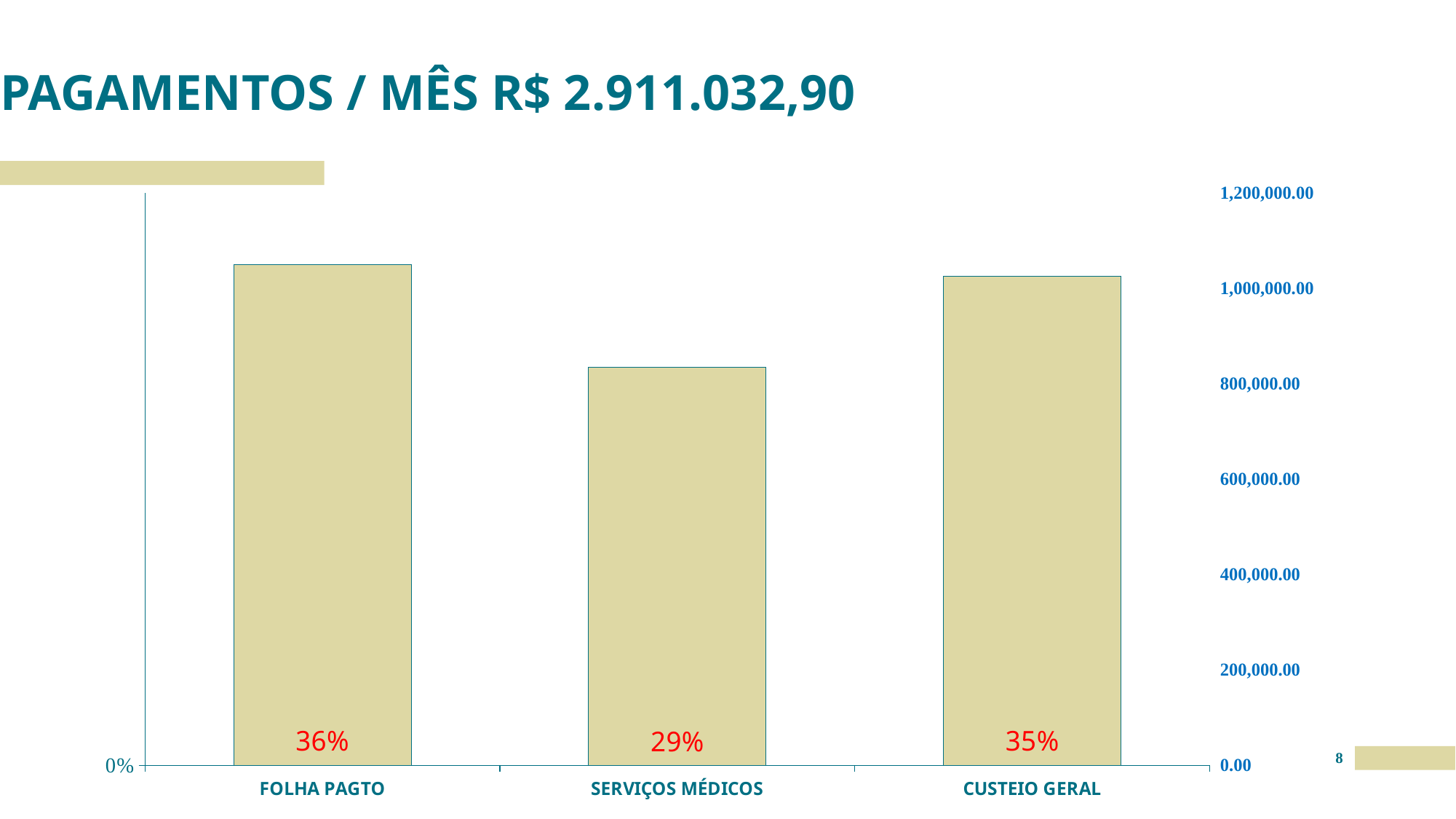
What is the title of the slide? PAGAMENTOS / MÊS R$ 2.911.032,90 Is the value for SERVIÇOS MÉDICOS on the right-hand axis greater or less than 1,000,000.00? less Is the value for FOLHA PAGTO on the right-hand axis greater or less than 1,000,000.00? greater Which has a larger percentage, FOLHA PAGTO or CUSTEIO GERAL? FOLHA PAGTO What is the difference in percentage points between FOLHA PAGTO and SERVIÇOS MÉDICOS? 7% What percentage label is shown on the FOLHA PAGTO bar? 36% What percentage label is shown on the SERVIÇOS MÉDICOS bar? 29% Which category has the highest percentage? FOLHA PAGTO Which category has the lowest percentage? SERVIÇOS MÉDICOS What percentage label is shown on the CUSTEIO GERAL bar? 35% How many categories are shown in the chart? 3 What kind of chart is shown on the slide? Bar chart